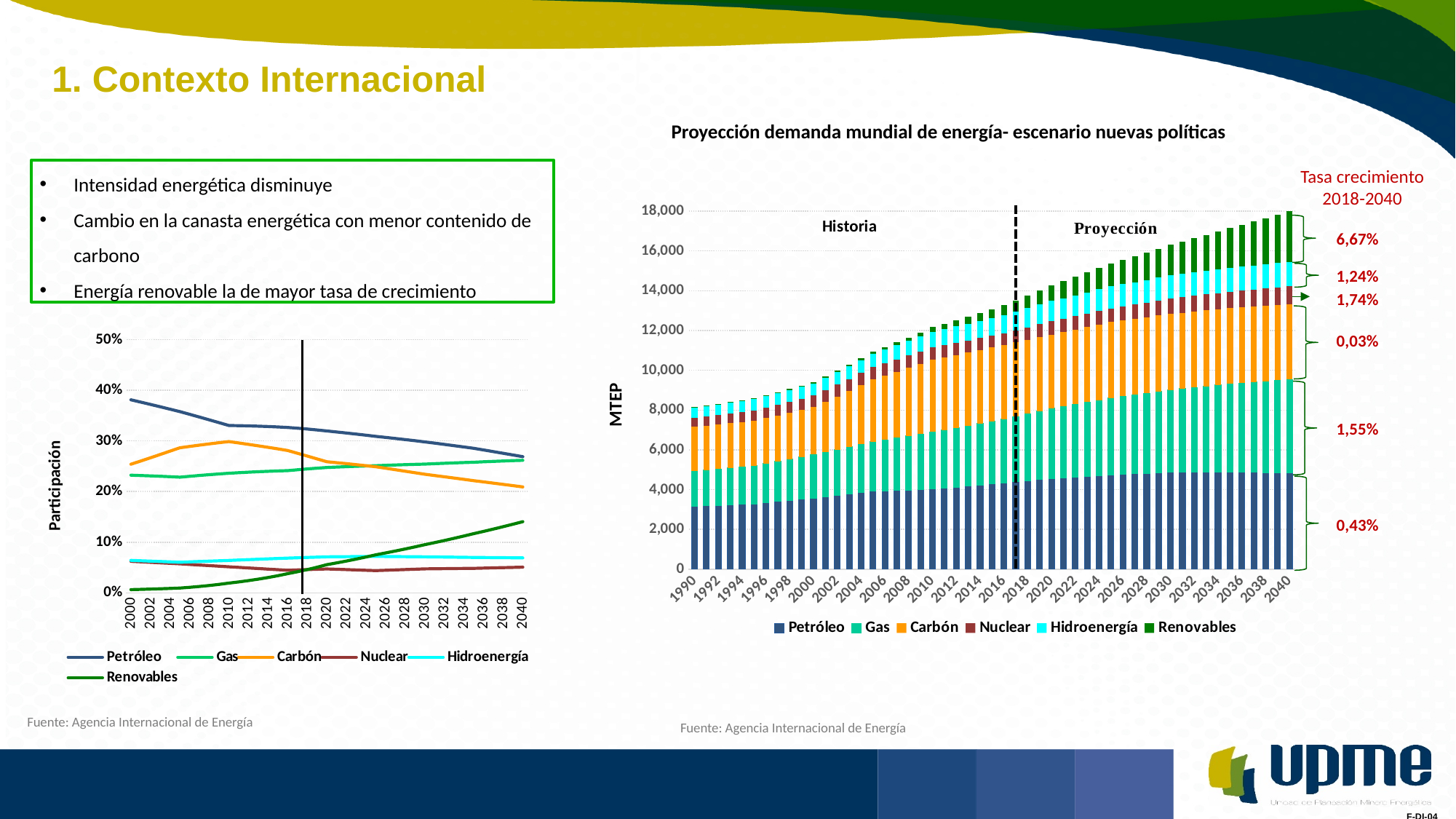
In the chart titled 'Proyección demanda mundial de energía- escenario nuevas políticas', how many series does the legend list? 6 In the chart titled 'Proyección demanda mundial de energía- escenario nuevas políticas', what growth rate for 2018-2040 is shown next to the Renovables segment? 6,67% In the left chart with the 'Participación' axis, is the value for Renovables in 2040 greater or less than 10%? greater In the left chart with the 'Participación' axis, does the Renovables line rise or fall from 2000 to 2040? rises In the chart titled 'Proyección demanda mundial de energía- escenario nuevas políticas', is the total bar for 2040 greater or less than 16,000? greater In the left chart with the 'Participación' axis, is the value for Petróleo in 2000 greater or less than 30%? greater What kind of chart is the chart titled 'Proyección demanda mundial de energía- escenario nuevas políticas'? Stacked bar chart In the left chart with the 'Participación' axis, which series has the highest share in 2000? Petróleo What kind of chart is the chart on the left with the 'Participación' axis? Line chart In the left chart with the 'Participación' axis, how many series does the legend list? 6 In the left chart with the 'Participación' axis, which is larger in 2000, Petróleo or Carbón? Petróleo